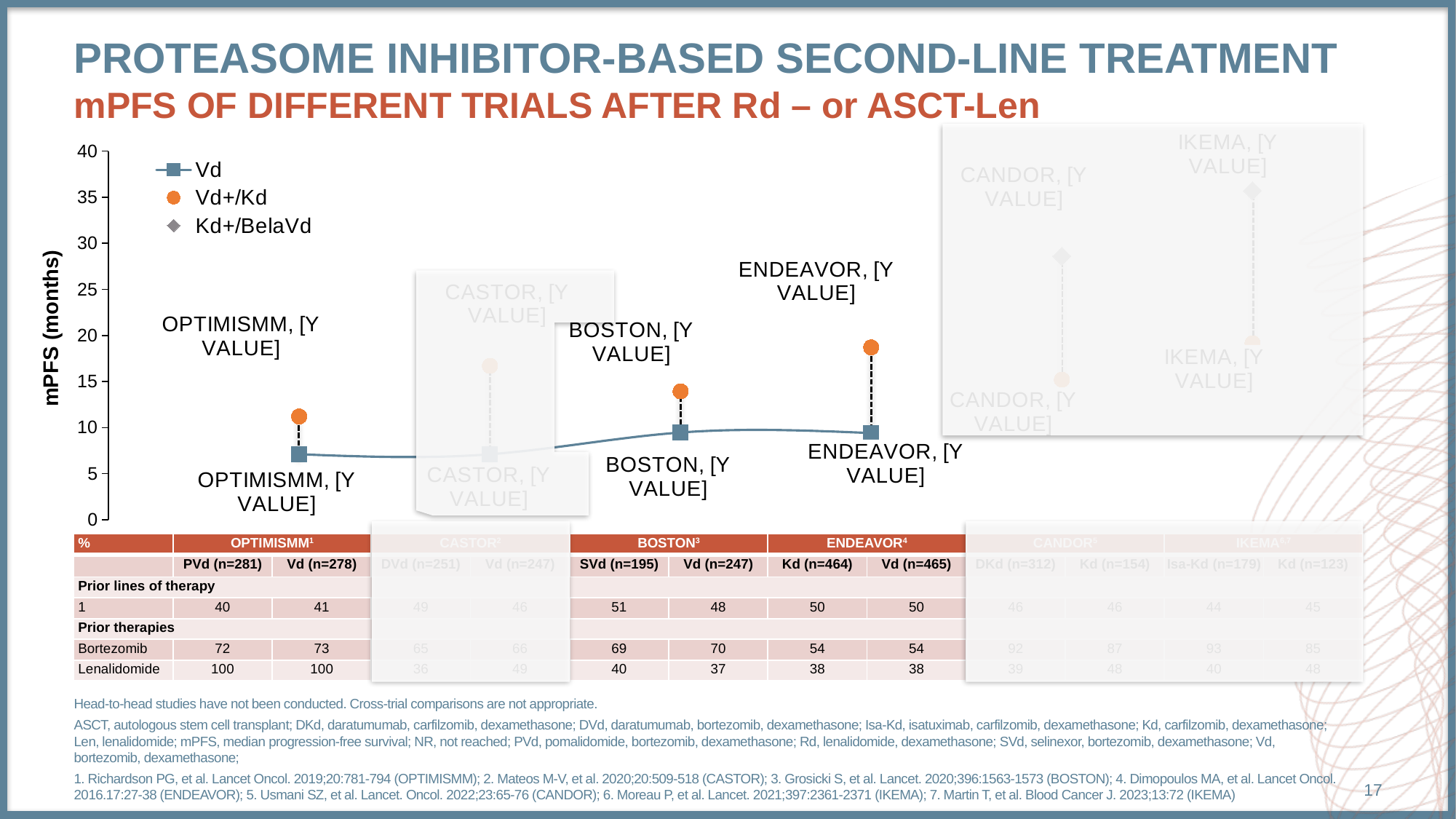
What kind of chart is shown on the slide? line chart How many series does the chart legend list? 3 What is the title of the chart's vertical axis? mPFS (months) Is the Vd value for OPTIMISMM greater or less than 10? less What are the three series named in the chart legend? Vd, Vd+/Kd, Kd+/BelaVd Which trial has the lowest Vd+/Kd value in the chart? OPTIMISMM Is the Vd+/Kd value for ENDEAVOR greater or less than 15? greater Is the Vd+/Kd value for OPTIMISMM greater or less than 15? less Which has the larger Vd value, OPTIMISMM or BOSTON? BOSTON Which has the larger Vd+/Kd value, BOSTON or ENDEAVOR? ENDEAVOR